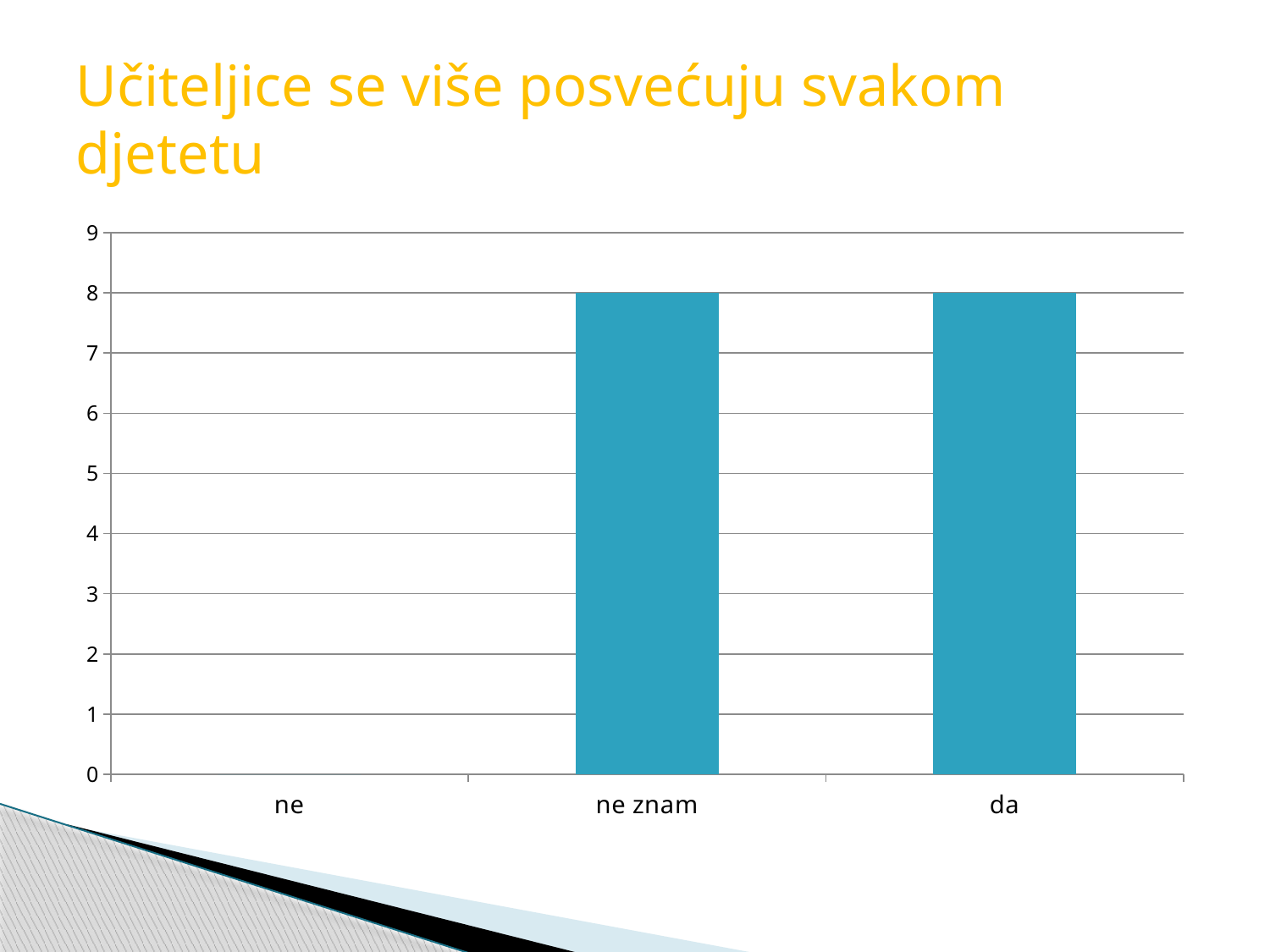
Which is larger, the value for "da" or the value for "ne"? da Which category has the lowest value? ne What is the title of the slide? Učiteljice se više posvećuju svakom djetetu What is the value for "ne znam"? 8 Is the value for "da" greater or less than 9? less What is the difference between the value for "da" and the value for "ne"? 8 What is the highest value shown on the y axis? 9 What is the value for "ne"? 0 What is the value for "da"? 8 How many categories are shown on the x axis? 3 Is the value for "ne znam" greater or less than 5? greater What kind of chart is shown on the slide? bar chart